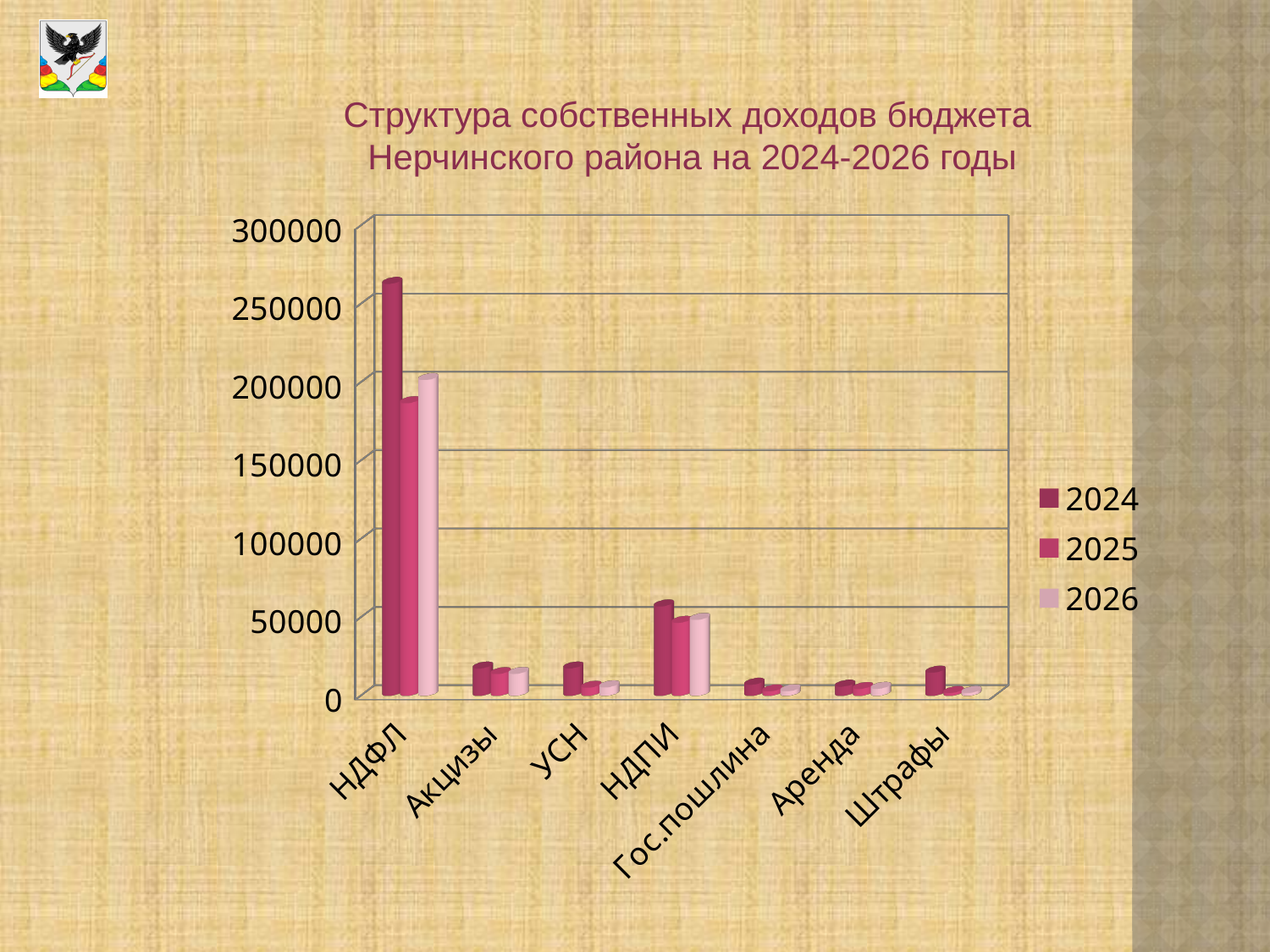
Is the 2024 value for НДПИ greater or less than 100000? less What kind of chart is shown on the slide? bar chart Is the 2025 value for НДФЛ greater or less than 150000? greater How many categories are shown on the x axis of the chart? 7 What is the title of the chart? Структура собственных доходов бюджета Нерчинского района на 2024-2026 годы Which category has the highest value for the 2026 series? НДФЛ For the 2024 series, which is larger: the value for НДПИ or the value for Акцизы? НДПИ How many series does the legend list? 3 Is the 2024 value for НДФЛ greater or less than 200000? greater For НДФЛ, which is larger: the 2024 value or the 2025 value? 2024 Which category has the highest value for the 2024 series? НДФЛ Which series are listed in the chart legend? 2024, 2025, 2026